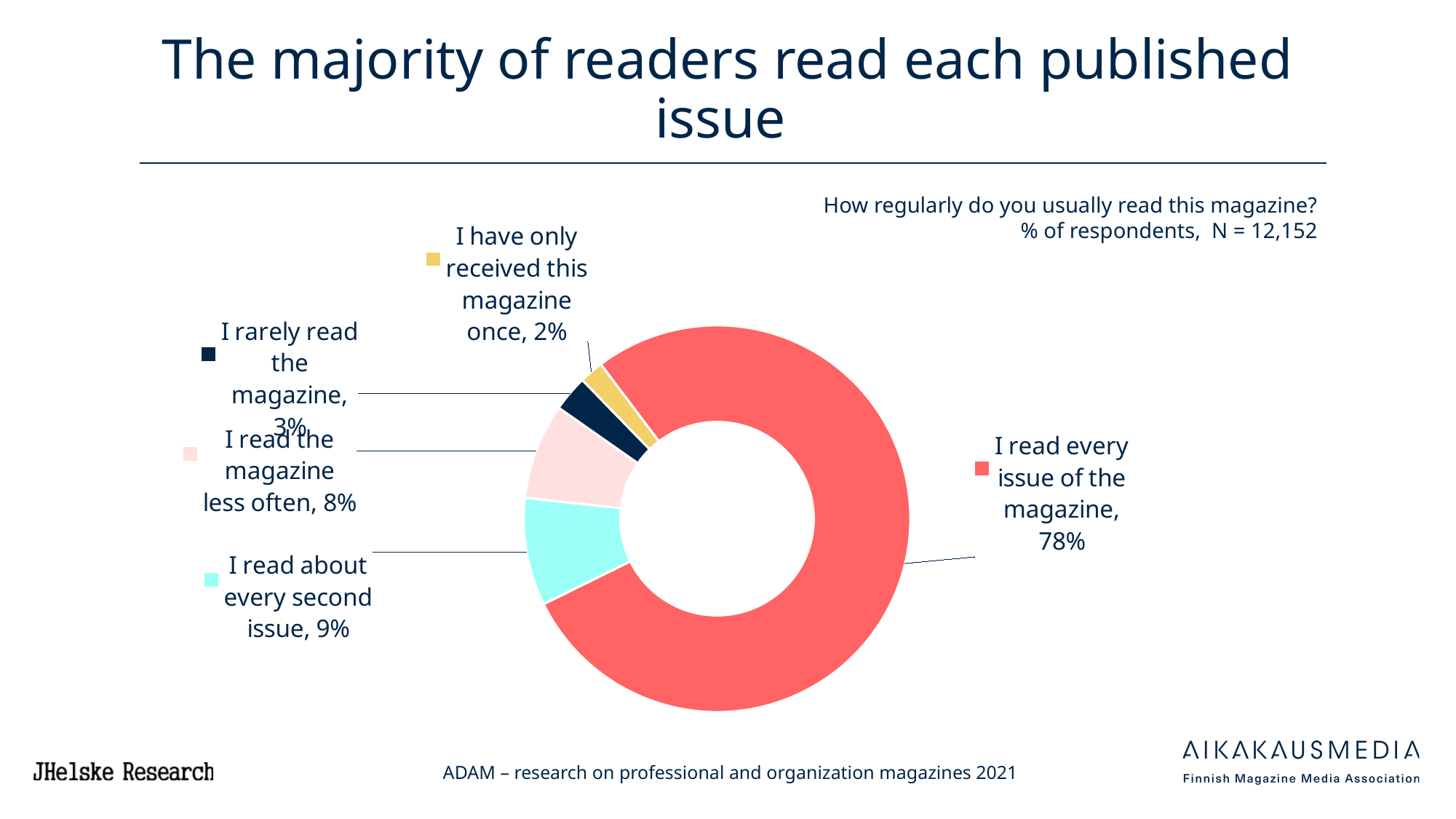
What percentage of respondents read the magazine less often? 8% How many response categories are shown in the chart? 5 What percentage of respondents rarely read the magazine? 3% What is the difference in percentage points between those who read every issue and those who read about every second issue? 69 What percentage of respondents read every issue of the magazine? 78% What percentage of respondents have only received this magazine once? 2% What kind of chart is shown on the slide? Pie chart (doughnut) Which is larger: the share who read about every second issue or the share who read the magazine less often? I read about every second issue What is the number of respondents (N) stated on the slide? 12,152 Which response has the largest share of respondents? I read every issue of the magazine What percentage of respondents read about every second issue? 9% Which response has the smallest share of respondents? I have only received this magazine once